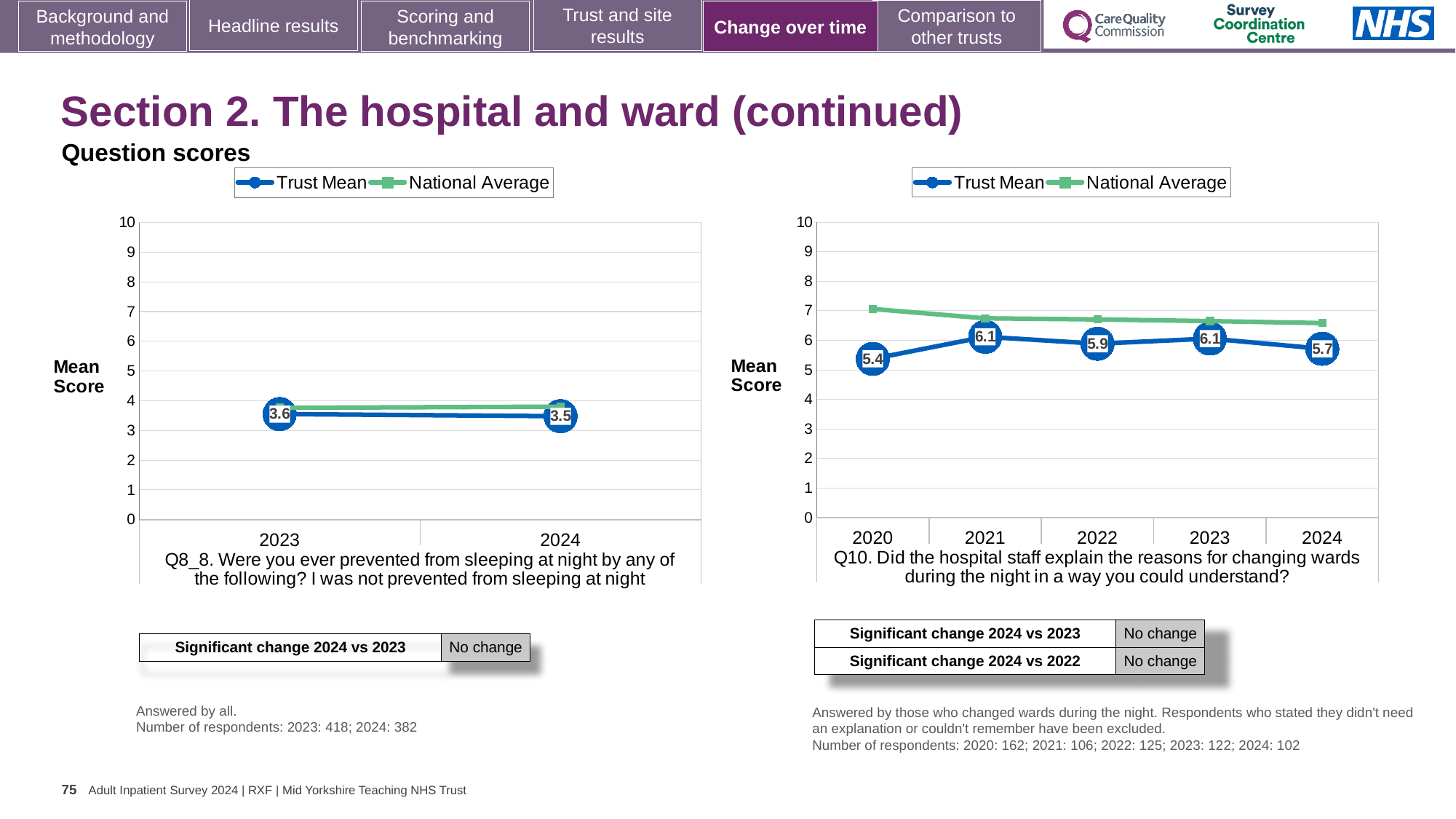
In the Q8_8 chart on the left, is the National Average for 2023 greater or less than 5? less In the Q10 chart on the right, which is larger: the Trust Mean for 2022 or the Trust Mean for 2024? 2022 In the Q8_8 chart on the left, what is the Trust Mean for 2024? 3.5 What kind of chart is the Q10 chart on the right? Line chart In the Q10 chart on the right, is the National Average for 2024 greater or less than 7? less In the Q10 chart on the right, what is the Trust Mean for 2024? 5.7 In the Q10 chart on the right, what is the Trust Mean for 2020? 5.4 How many series does the legend of the Q8_8 chart on the left list? 2 In the Q8_8 chart on the left, what is the Trust Mean for 2023? 3.6 In the Q10 chart on the right, which year has the lowest Trust Mean? 2020 How many years are shown on the x axis of the Q10 chart on the right? 5 In the Q10 chart on the right, what is the difference between the Trust Mean for 2021 and the Trust Mean for 2020? 0.7